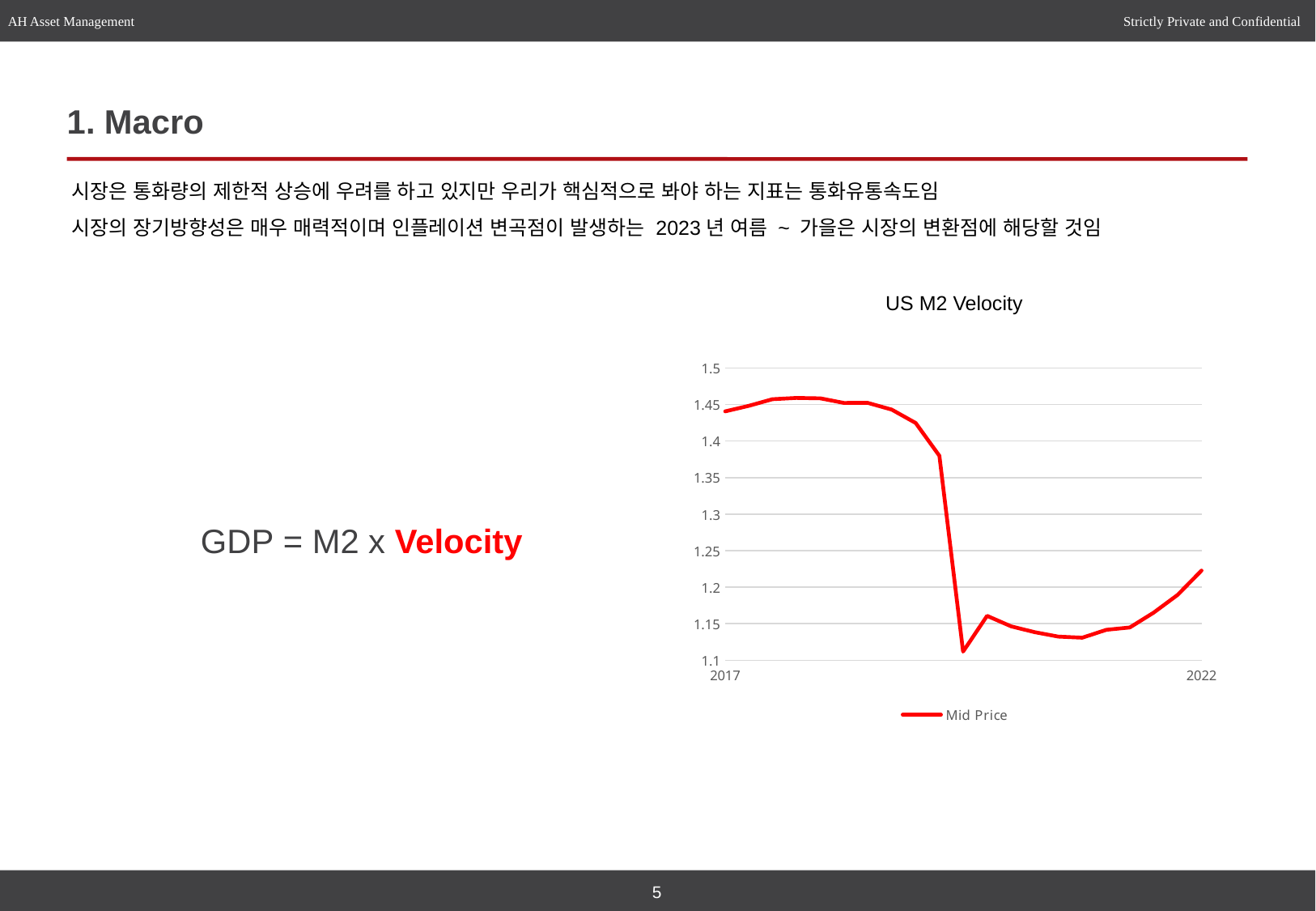
Is the value of Mid Price at the end of the chart (2022) greater or less than 1.25? less Is the highest value of Mid Price on the chart greater or less than 1.5? less Is the value of Mid Price at the end of the chart (2022) greater or less than 1.2? greater Which is larger, the Mid Price value at 2017 or at 2022? 2017 What is the title of the chart on the slide? US M2 Velocity What is the name of the series shown in the chart's legend? Mid Price How many series does the chart's legend list? 1 What kind of chart is shown on the slide? line chart Overall, does the Mid Price line rise or fall from 2017 to 2022? fall What is the lowest value shown on the chart's vertical axis? 1.1